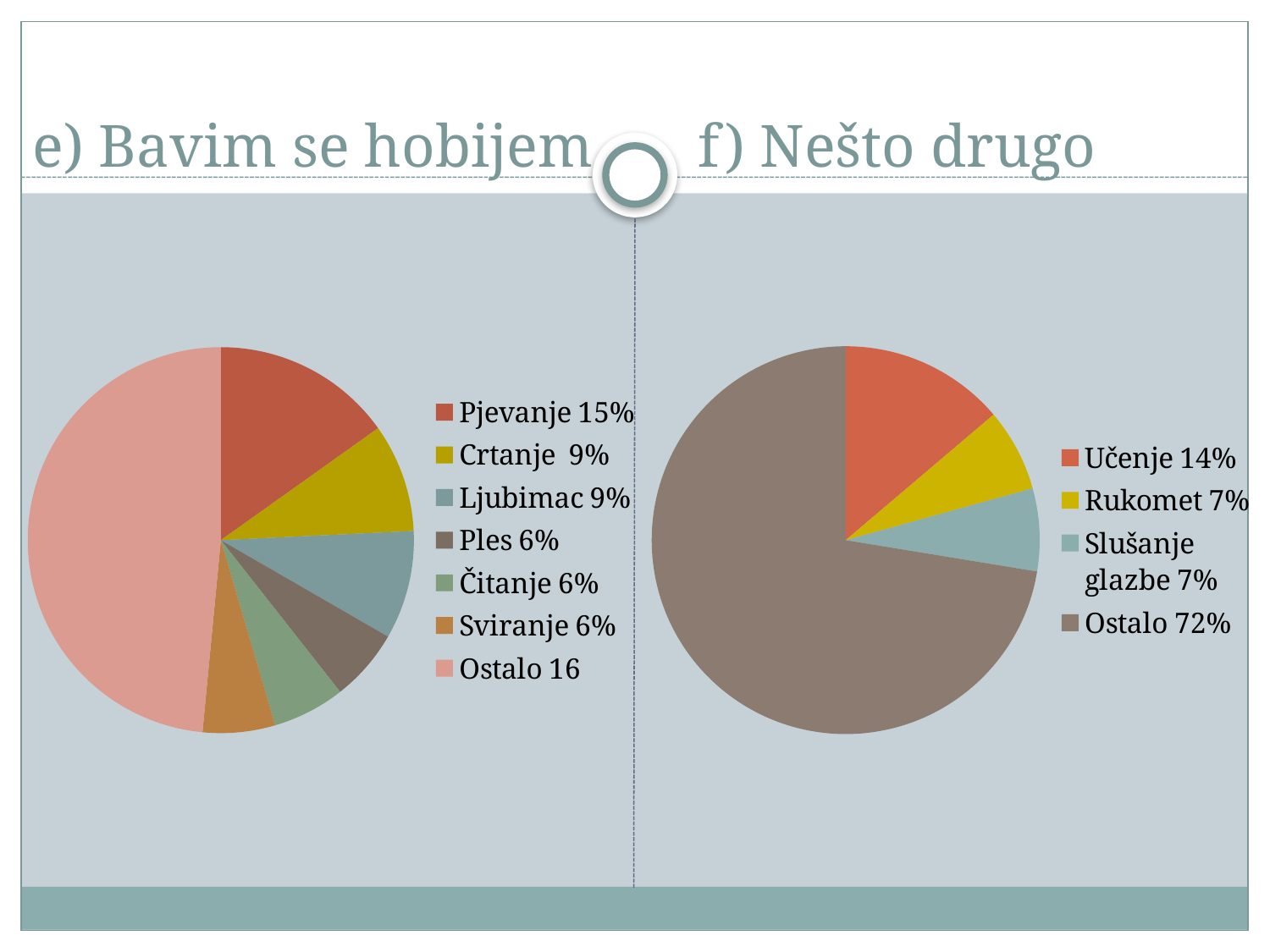
How many categories does the legend of the "e) Bavim se hobijem" chart list? 7 In the "f) Nešto drugo" chart, what is the value for Učenje? 14% What kind of chart is shown under "e) Bavim se hobijem"? pie chart In the "e) Bavim se hobijem" chart, what is the value for Ples? 6% In the "f) Nešto drugo" chart, which category has the largest share? Ostalo In the "f) Nešto drugo" chart, what share does Ostalo have? 72% In the "e) Bavim se hobijem" chart, what is the value for Crtanje? 9% In the "f) Nešto drugo" chart, what is the difference between Ostalo and Učenje? 58% In the "e) Bavim se hobijem" chart, which is larger, Pjevanje or Ples? Pjevanje How many categories does the legend of the "f) Nešto drugo" chart list? 4 In the "e) Bavim se hobijem" chart, what is the difference between Pjevanje and Ljubimac? 6% In the "e) Bavim se hobijem" chart, what is the value for Pjevanje? 15%